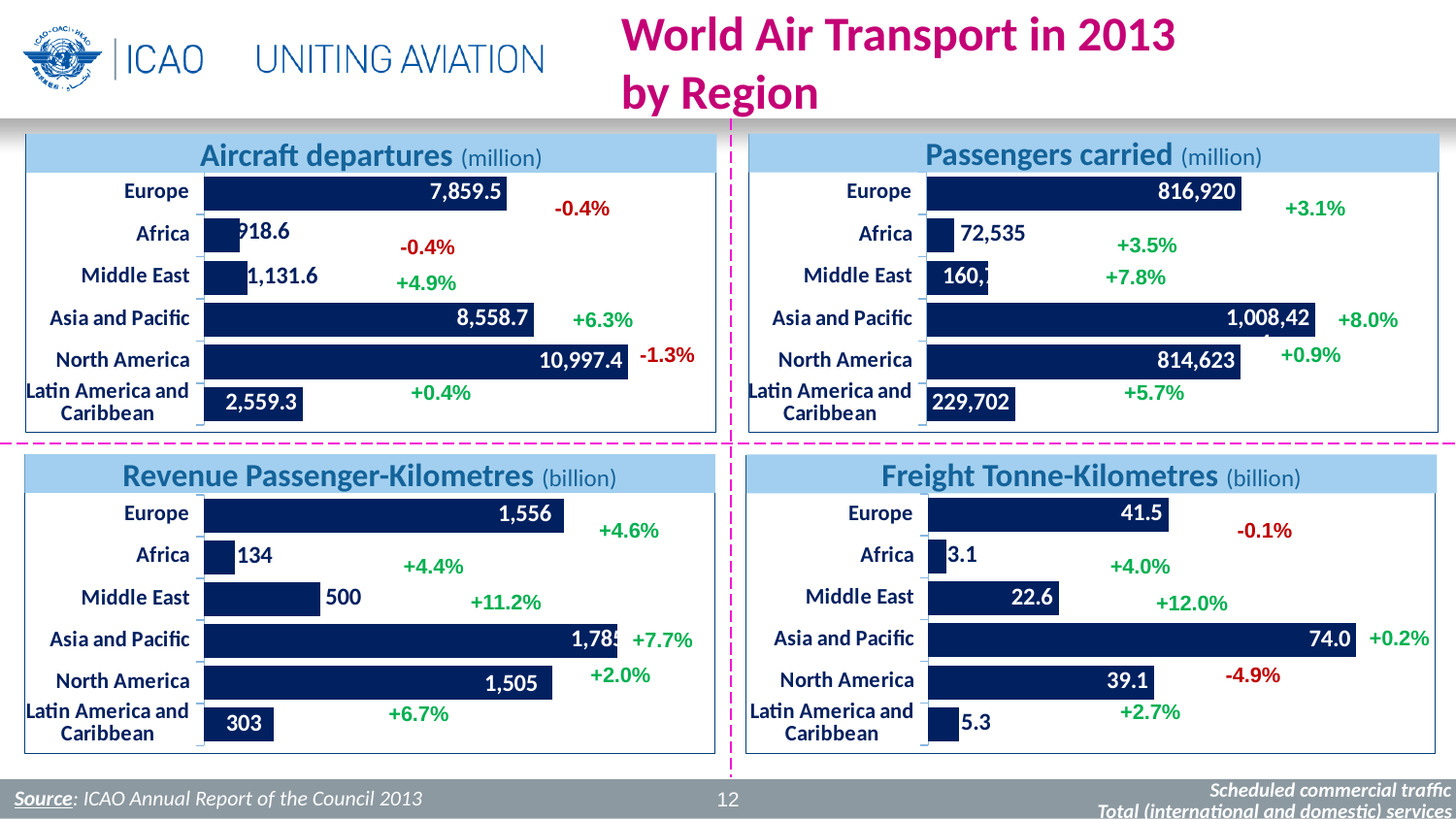
How many regions are shown in the Freight Tonne-Kilometres chart? 6 In the Revenue Passenger-Kilometres chart, what is the value for Middle East? 500 In the Aircraft departures chart, what is the value for North America? 10,997.4 In the Passengers carried chart, what is the value for Europe? 816,920 In the Passengers carried chart, what is the difference between Europe and North America? 2,297 What type of chart is the Revenue Passenger-Kilometres chart? Bar chart In the Freight Tonne-Kilometres chart, what is the value for Asia and Pacific? 74.0 In the Freight Tonne-Kilometres chart, what is the difference between Europe and North America? 2.4 In the Revenue Passenger-Kilometres chart, which is larger, Europe or North America? Europe In the Passengers carried chart, which region has the lowest value? Africa In the Aircraft departures chart, which region has the highest value? North America In the Aircraft departures chart, what is the value for Latin America and Caribbean? 2,559.3